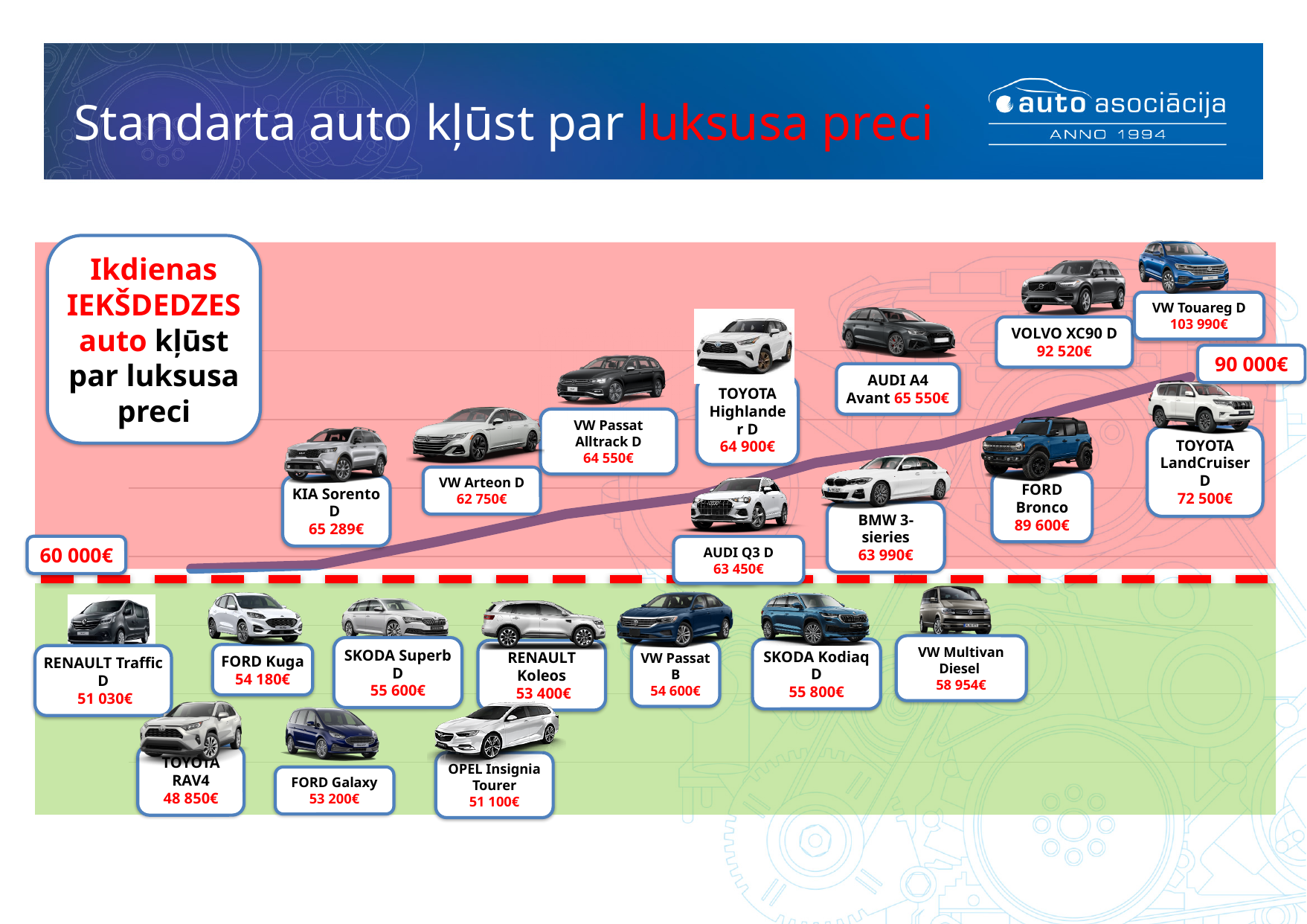
How many cars are shown with prices on the slide? 21 Which is more expensive, the VW Multivan Diesel or the FORD Kuga? VW Multivan Diesel Is the price of the FORD Bronco greater or less than 90 000€? less What is the price shown for the TOYOTA RAV4? 48 850€ What is the price shown for the VW Touareg D? 103 990€ What is the difference in price between the FORD Bronco and the TOYOTA LandCruiser D? 17 100€ What is the difference in price between the VW Touareg D and the VOLVO XC90 D? 11 470€ What is the price shown for the SKODA Kodiaq D? 55 800€ Which car has the highest price on the slide? VW Touareg D Which car has the lowest price on the slide? TOYOTA RAV4 What is the price shown for the FORD Bronco? 89 600€ What is the title of the slide? Standarta auto kļūst par luksusa preci